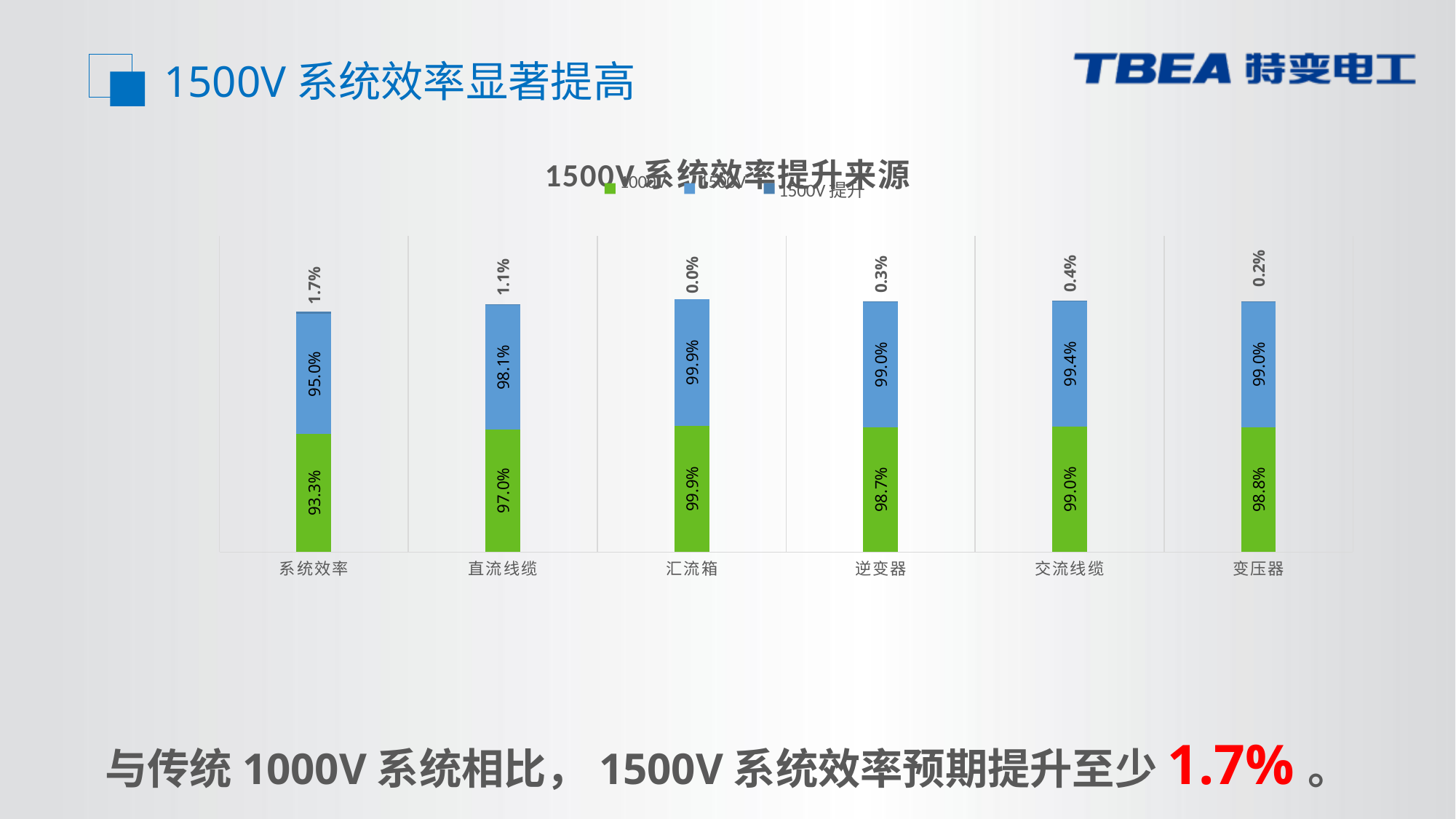
Which is larger, the 1000V value for 直流线缆 or the 1000V value for 变压器? 变压器 What kind of chart is shown on the slide? Stacked bar chart How many series does the legend list? 3 Which category has the lowest 1500V 提升 value? 汇流箱 What is the 1000V value for 系统效率? 93.3% What is the title of the chart? 1500V 系统效率提升来源 What is the 1500V value for 直流线缆? 98.1% How many categories are shown on the x axis? 6 What is the 1000V value for 逆变器? 98.7% Which category has the highest 1500V 提升 value? 系统效率 What is the difference between the 1500V and 1000V values for 系统效率? 1.7% What is the 1500V 提升 value for 交流线缆? 0.4%